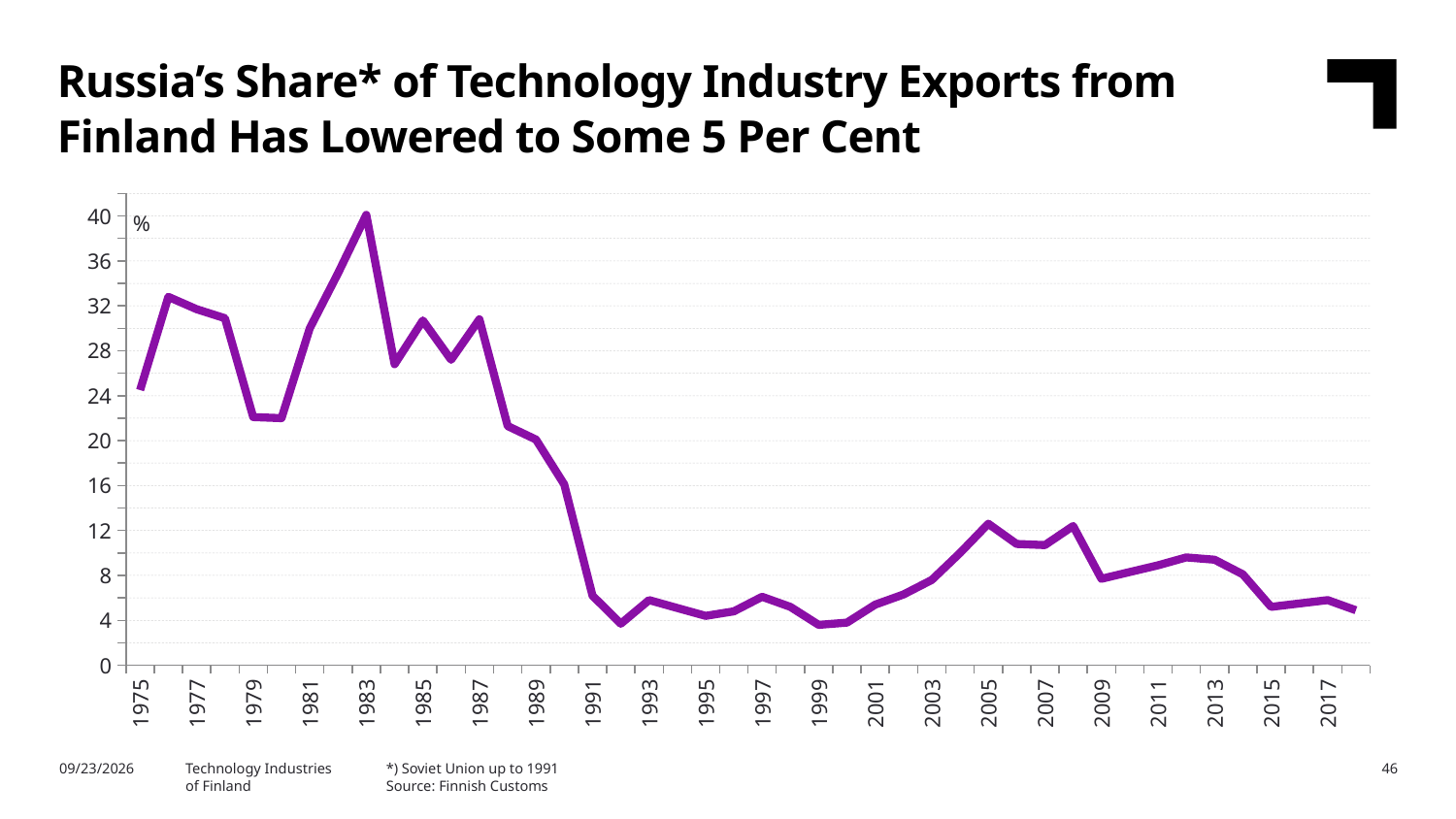
What kind of chart is shown on the slide? line chart Is the value for 2009 greater or less than 12? less Which year has the larger value, 2005 or 2015? 2005 Is the value for 1983 greater or less than 36? greater Is the value for 1991 greater or less than 8? less Overall, does the line rise or fall from 1975 to the end of the series? fall What unit is shown at the top of the y axis? % In which year does the line reach its highest value? 1983 Which year has the larger value, 1983 or 1987? 1983